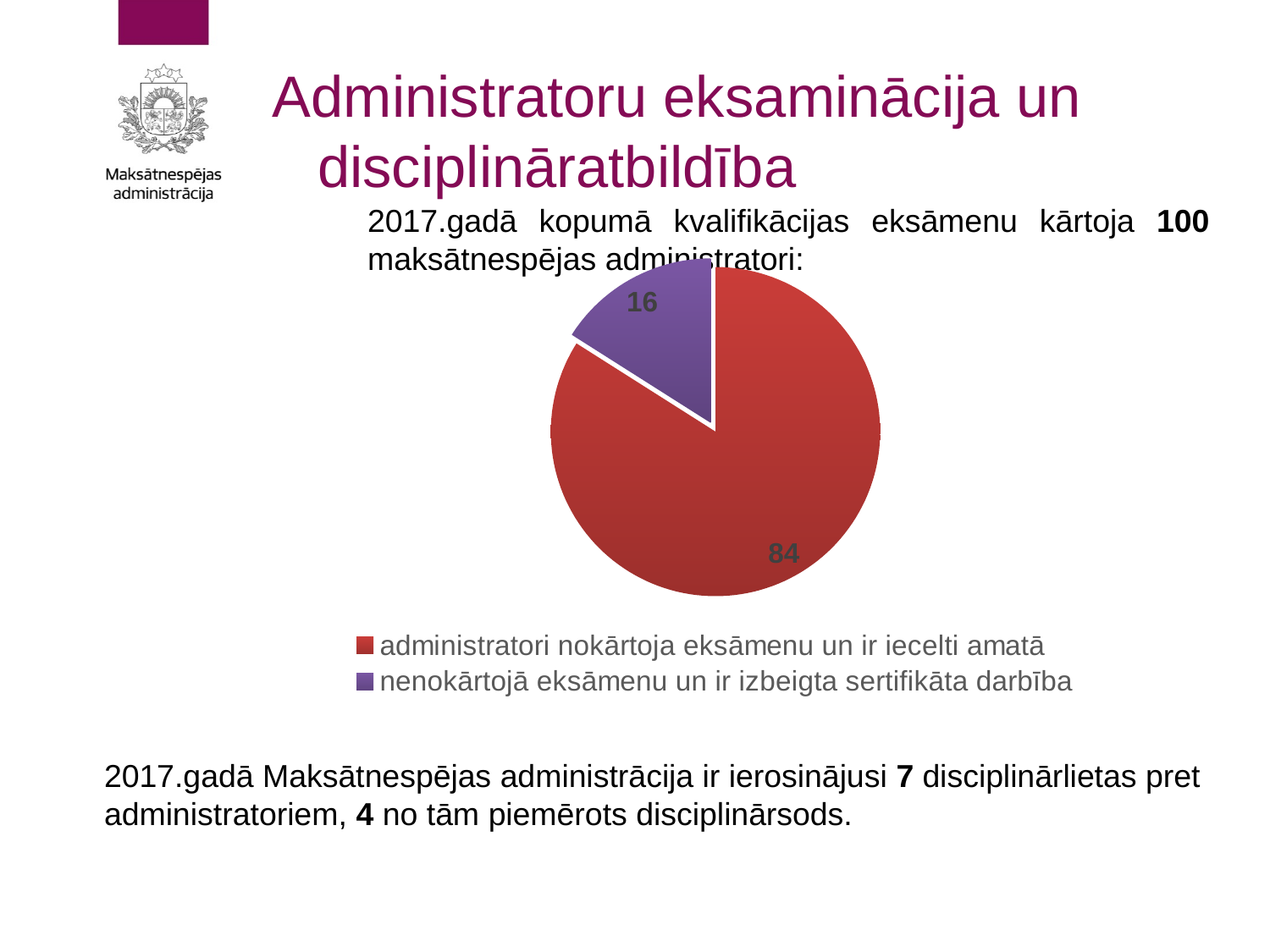
How many entries does the legend list? 2 Which is larger: the value for "administratori nokārtoja eksāmenu un ir iecelti amatā" or the value for "nenokārtojā eksāmenu un ir izbeigta sertifikāta darbība"? administratori nokārtoja eksāmenu un ir iecelti amatā Which category has the smallest slice of the pie? nenokārtojā eksāmenu un ir izbeigta sertifikāta darbība What is the total of the two slices in the pie chart? 100 What kind of chart is shown on the slide? pie chart Which category has the largest slice of the pie? administratori nokārtoja eksāmenu un ir iecelti amatā What is the difference between the value for "administratori nokārtoja eksāmenu un ir iecelti amatā" and the value for "nenokārtojā eksāmenu un ir izbeigta sertifikāta darbība"? 68 What is the value for "nenokārtojā eksāmenu un ir izbeigta sertifikāta darbība"? 16 How many slices does the pie chart have? 2 What is the value for "administratori nokārtoja eksāmenu un ir iecelti amatā"? 84 What colour is the slice for "nenokārtojā eksāmenu un ir izbeigta sertifikāta darbība"? purple What share of the pie does the slice "nenokārtojā eksāmenu un ir izbeigta sertifikāta darbība" represent? 16%